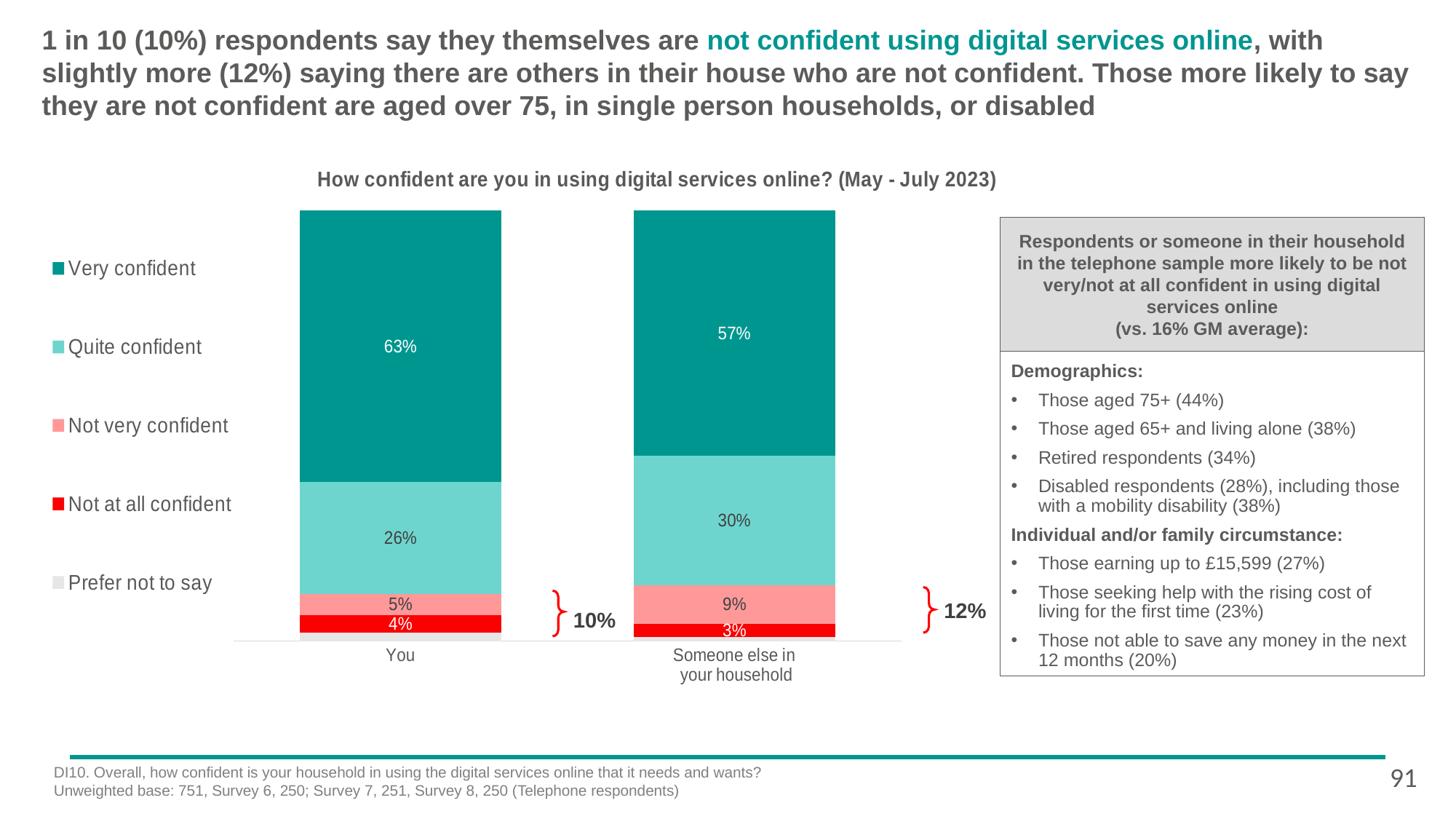
What percentage say someone else in their household is quite confident? 30% How many series does the chart legend list? 5 How many bars (categories) are shown on the chart? 2 What percentage of respondents say they themselves are very confident using digital services online? 63% What is the combined 'Not very confident' and 'Not at all confident' share for the 'Someone else in your household' bar, as annotated on the chart? 12% What is the title of the chart? How confident are you in using digital services online? (May - July 2023) What type of chart is shown on the slide? Stacked bar chart What is the 'Not at all confident' value for the 'You' bar? 4% What is the 'Not very confident' value for the 'Someone else in your household' bar? 9% What is the combined 'Not very confident' and 'Not at all confident' share for the 'You' bar, as annotated on the chart? 10% What is the difference between the 'Quite confident' values for 'Someone else in your household' and 'You'? 4 percentage points Which bar has the larger 'Very confident' share, 'You' or 'Someone else in your household'? You